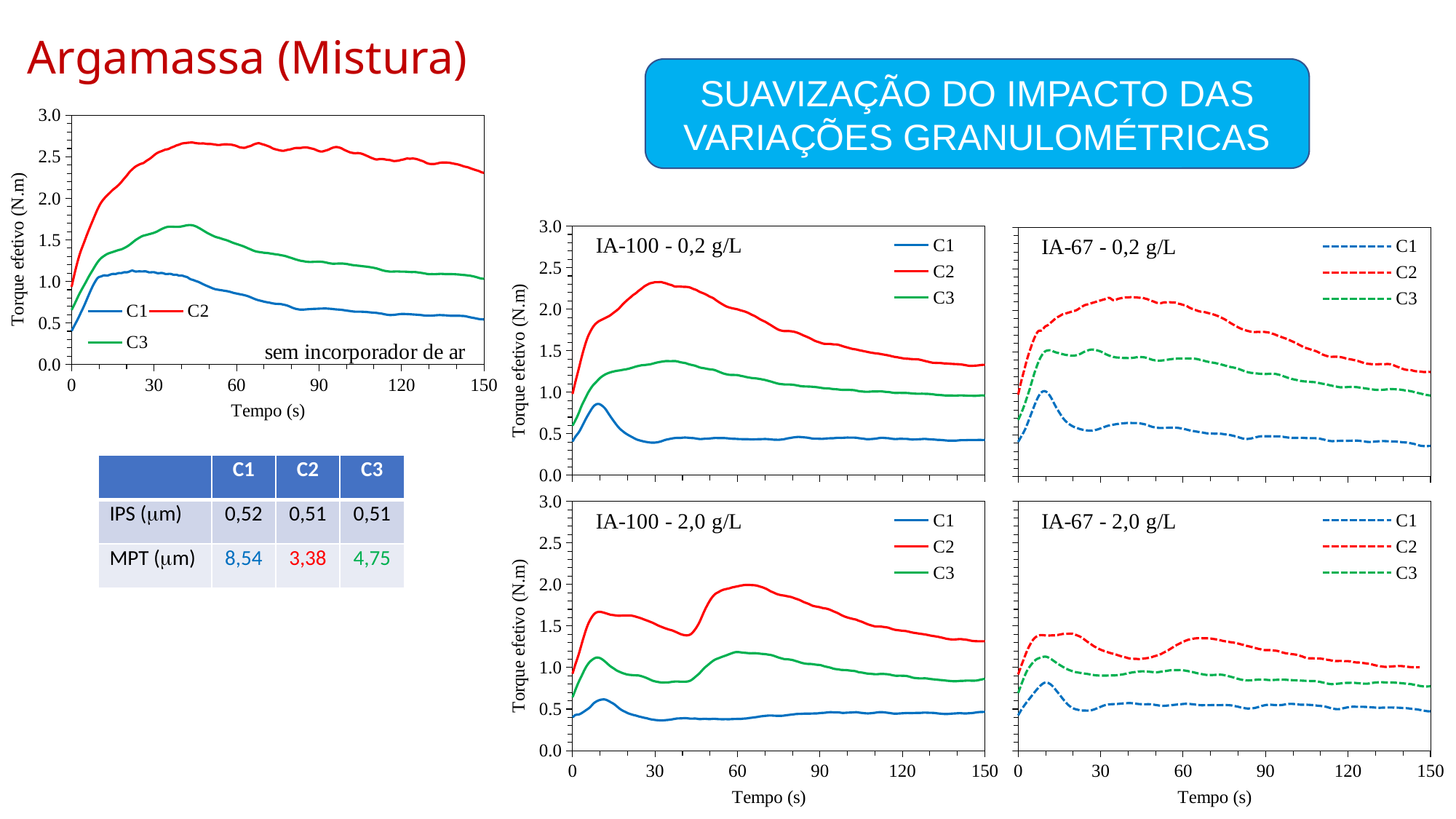
In the 'IA-100 - 0,2 g/L' chart, is the peak value of C2 greater or less than 2.0? greater In the 'IA-100 - 2,0 g/L' chart, is the peak value of C1 greater or less than 1.0? less What kind of chart is the 'sem incorporador de ar' chart on the left of the slide? line chart How are the series lines drawn in the 'IA-67 - 0,2 g/L' chart, solid or dashed? dashed In the 'sem incorporador de ar' chart, which series has the lowest torque values? C1 What is the y-axis label of the 'IA-100 - 2,0 g/L' chart? Torque efetivo (N.m) In the 'IA-67 - 2,0 g/L' chart, is the peak value of C2 greater or less than 2.0? less In the 'IA-100 - 0,2 g/L' chart, after reaching its peak, does the C2 series rise or fall toward 150 s? fall How many series does the legend of the 'IA-100 - 0,2 g/L' chart list? 3 In the 'IA-67 - 2,0 g/L' chart, which series is higher at 150 s, C2 or C3? C2 In the 'sem incorporador de ar' chart, which series reaches the highest torque? C2